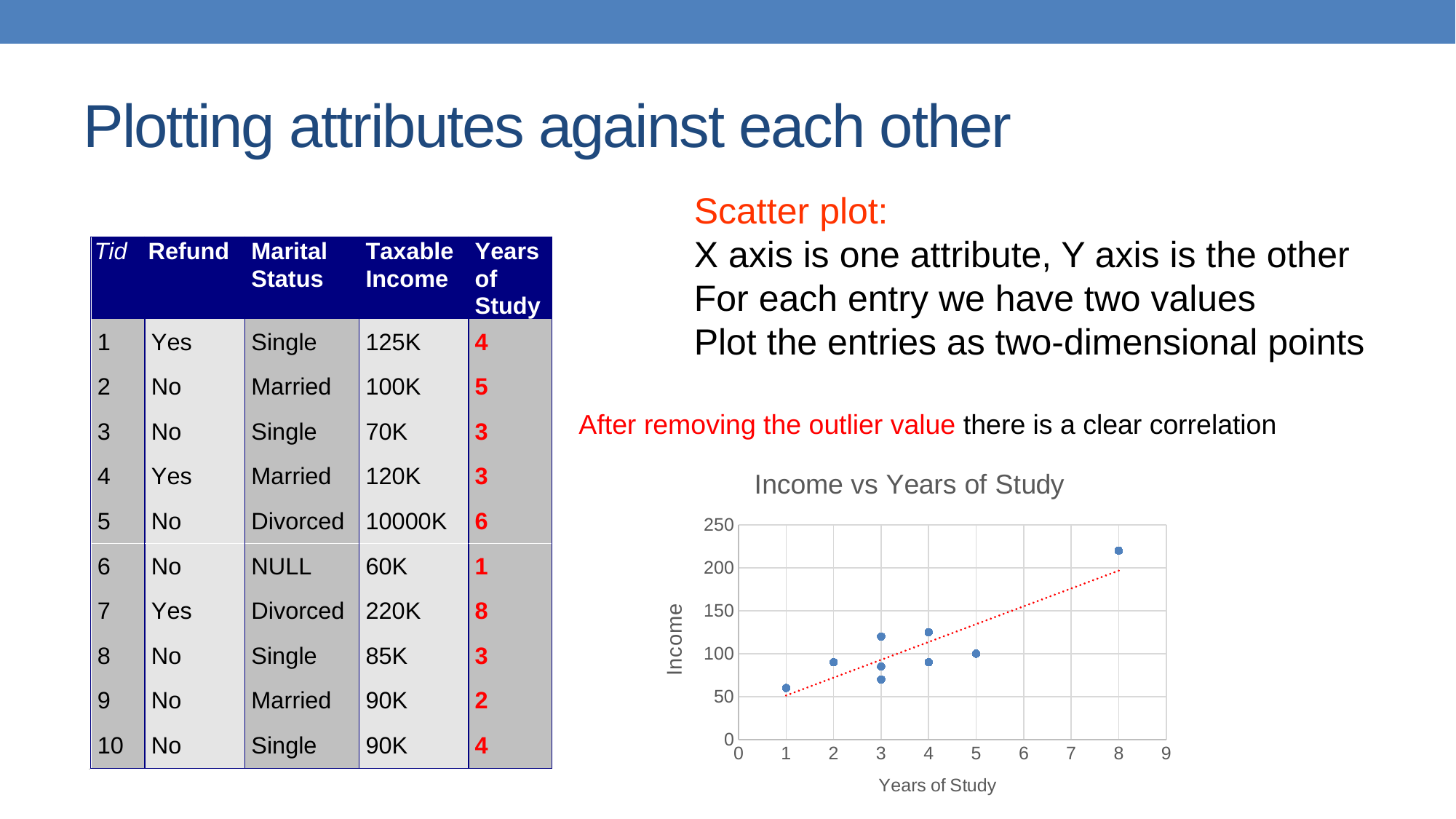
What is the label of the y axis of the chart? Income How many data points are plotted in the chart? 9 Does income generally rise or fall as years of study increase along the x axis? rise Is the income value for the point at 8 years of study greater or less than 200? greater What is the title of the chart? Income vs Years of Study Is the income value for the point at 2 years of study greater or less than 50? greater At how many years of study is the point with the highest income? 8 At how many years of study is the point with the lowest income? 1 How many data points are plotted at 3 years of study? 3 What kind of chart is shown on the slide? scatter plot Is the income value for the point at 1 year of study greater or less than 100? less What is the income value of the point at 5 years of study? 100